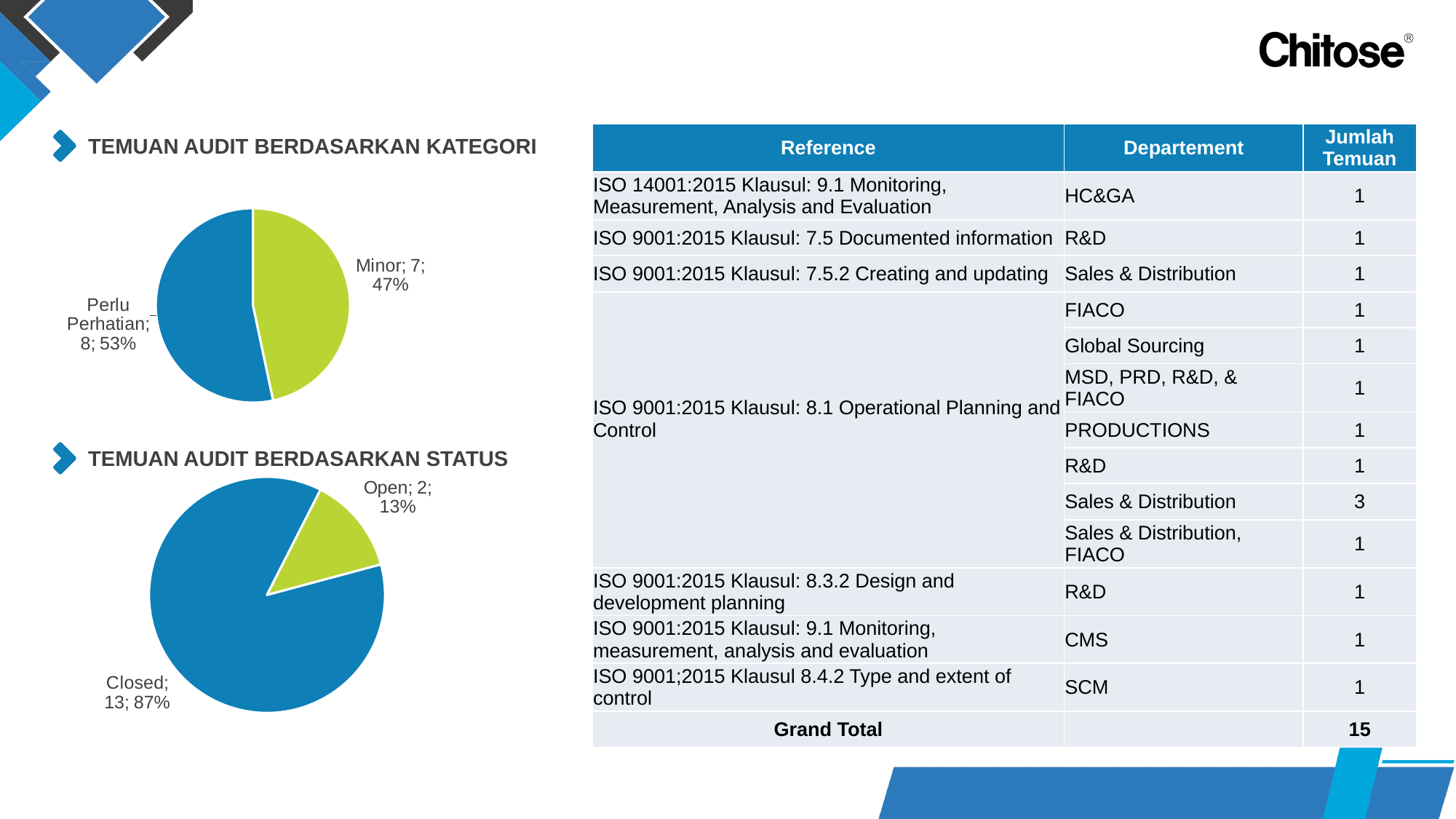
In the 'TEMUAN AUDIT BERDASARKAN STATUS' chart, what is the total of the Closed and Open values? 15 In the 'TEMUAN AUDIT BERDASARKAN STATUS' chart, is the value for Closed or Open larger? Closed In the 'TEMUAN AUDIT BERDASARKAN KATEGORI' chart, what is the value for Minor? 7 In the 'TEMUAN AUDIT BERDASARKAN KATEGORI' chart, what share of the pie is Perlu Perhatian? 53% In the 'TEMUAN AUDIT BERDASARKAN KATEGORI' chart, what kind of chart is shown? pie chart In the 'TEMUAN AUDIT BERDASARKAN STATUS' chart, what share of the pie is Open? 13% In the 'TEMUAN AUDIT BERDASARKAN KATEGORI' chart, what is the difference between the Perlu Perhatian and Minor counts? 1 In the 'TEMUAN AUDIT BERDASARKAN KATEGORI' chart, which category has the largest slice? Perlu Perhatian In the 'TEMUAN AUDIT BERDASARKAN KATEGORI' chart, how many slices does the pie have? 2 In the 'TEMUAN AUDIT BERDASARKAN STATUS' chart, what is the value for Closed? 13 In the 'TEMUAN AUDIT BERDASARKAN STATUS' chart, which category has the smallest slice? Open In the 'TEMUAN AUDIT BERDASARKAN STATUS' chart, what colour is the Closed slice? blue